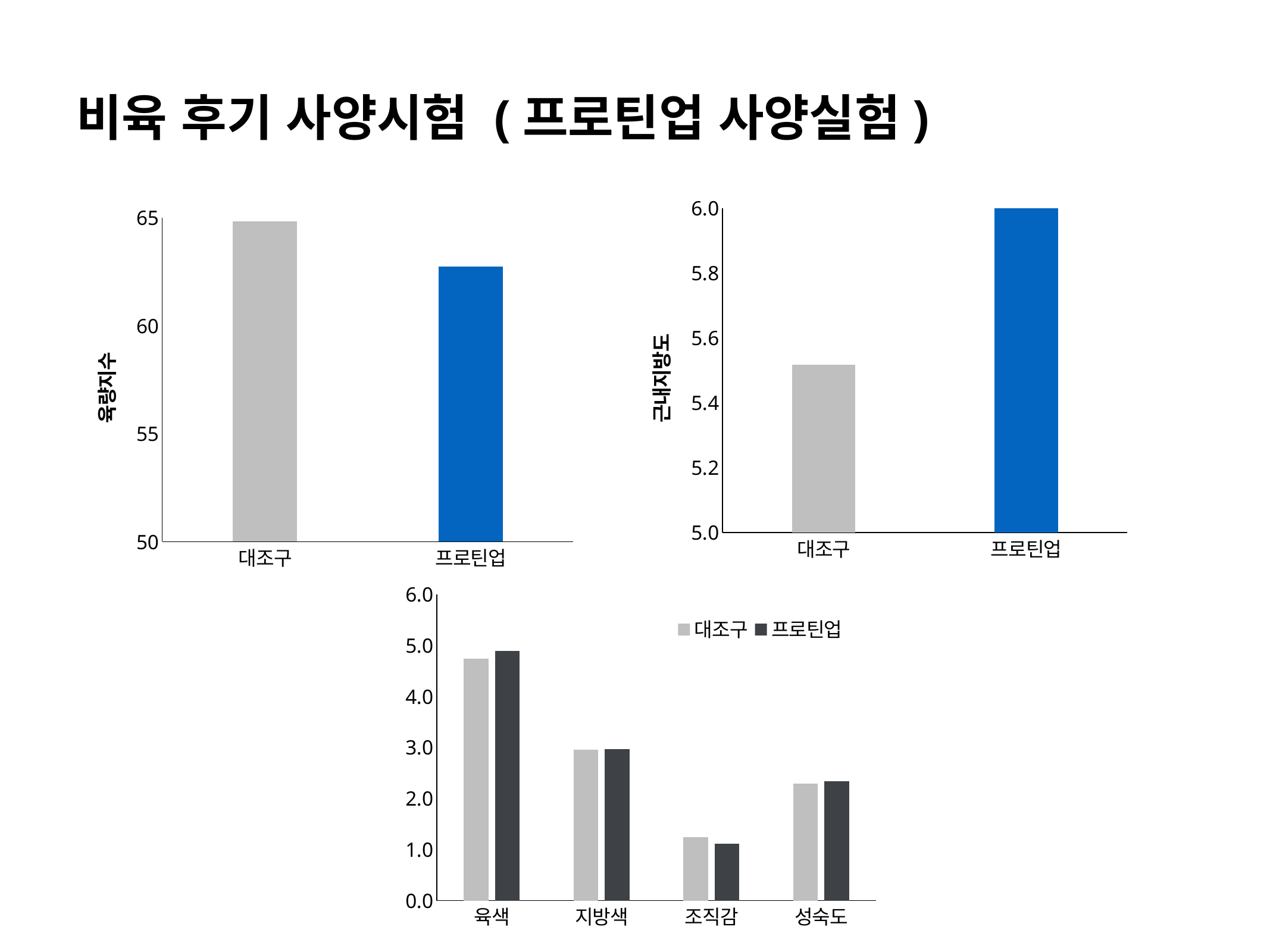
What is the y-axis label of the top-right chart? 근내지방도 How many series does the legend of the bottom chart list? 2 In the bottom chart, which category has the lowest values for both series? 조직감 In the bottom chart, for 조직감, which series has the larger value, 대조구 or 프로틴업? 대조구 In the top-right chart (근내지방도), is the value for 대조구 greater or less than 5.4? greater In the top-left chart (육량지수), is the value for 프로틴업 greater or less than 60? greater In the top-right chart (근내지방도), which category has the highest value? 프로틴업 In the top-left chart (육량지수), is the value for 대조구 greater or less than 65? less How many categories are shown on the x axis of the bottom chart? 4 In the top-left chart (육량지수), which category has the higher value, 대조구 or 프로틴업? 대조구 What kind of chart is the top-left chart with the y-axis labelled 육량지수? bar chart